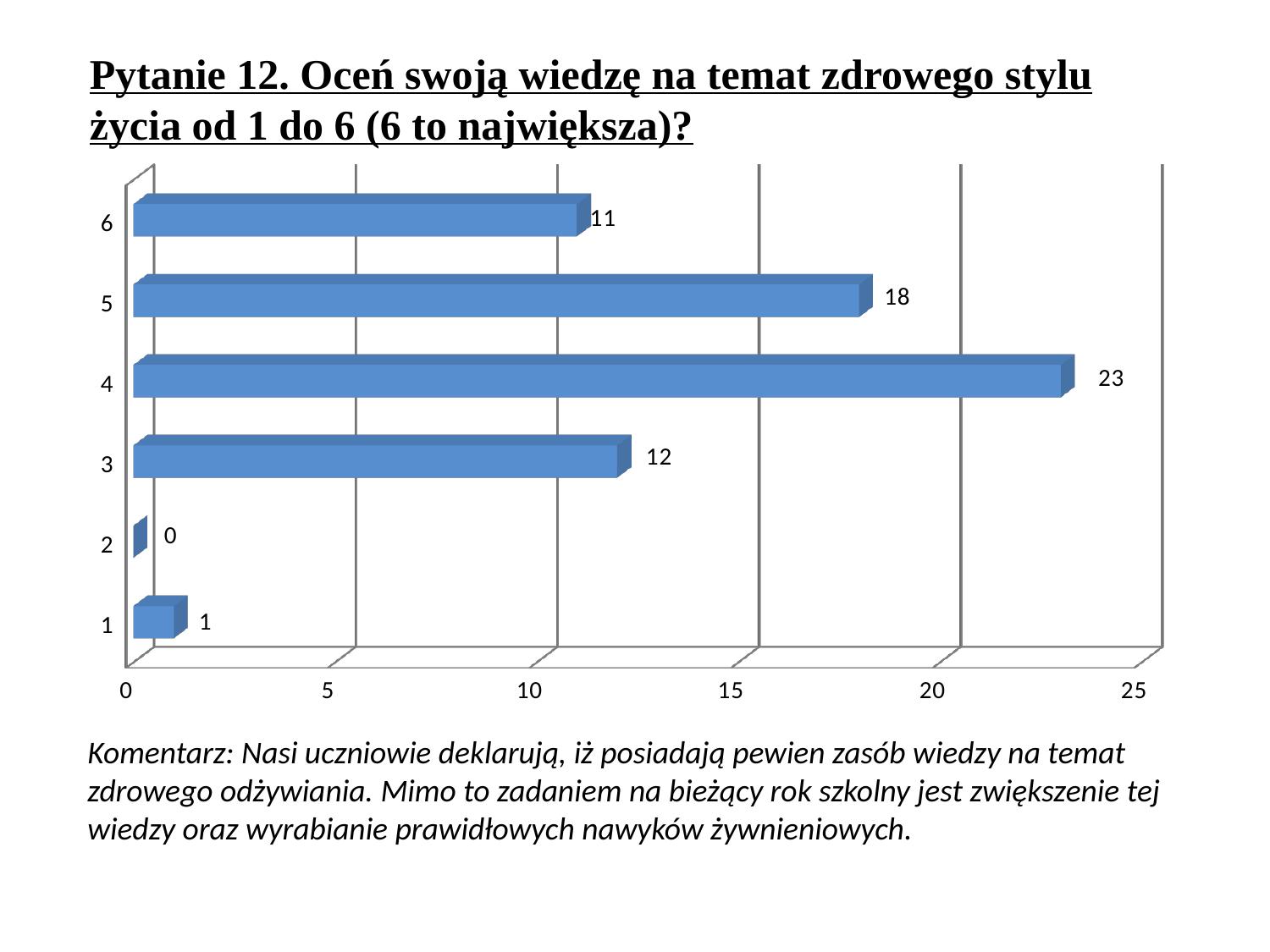
What is the maximum value shown on the horizontal axis? 25 Which is larger, the value for rating 3 or the value for rating 6? rating 3 What is the difference between the values for rating 4 and rating 5? 5 Which rating has the highest value? 4 How many rating categories are shown on the chart? 6 Is the value for rating 5 greater or less than 15? greater What is the value for rating 4? 23 What is the total of the values for ratings 5 and 6? 29 What is the value for rating 2? 0 Which rating has the lowest value? 2 What is the value for rating 6? 11 What kind of chart is shown on the slide? bar chart